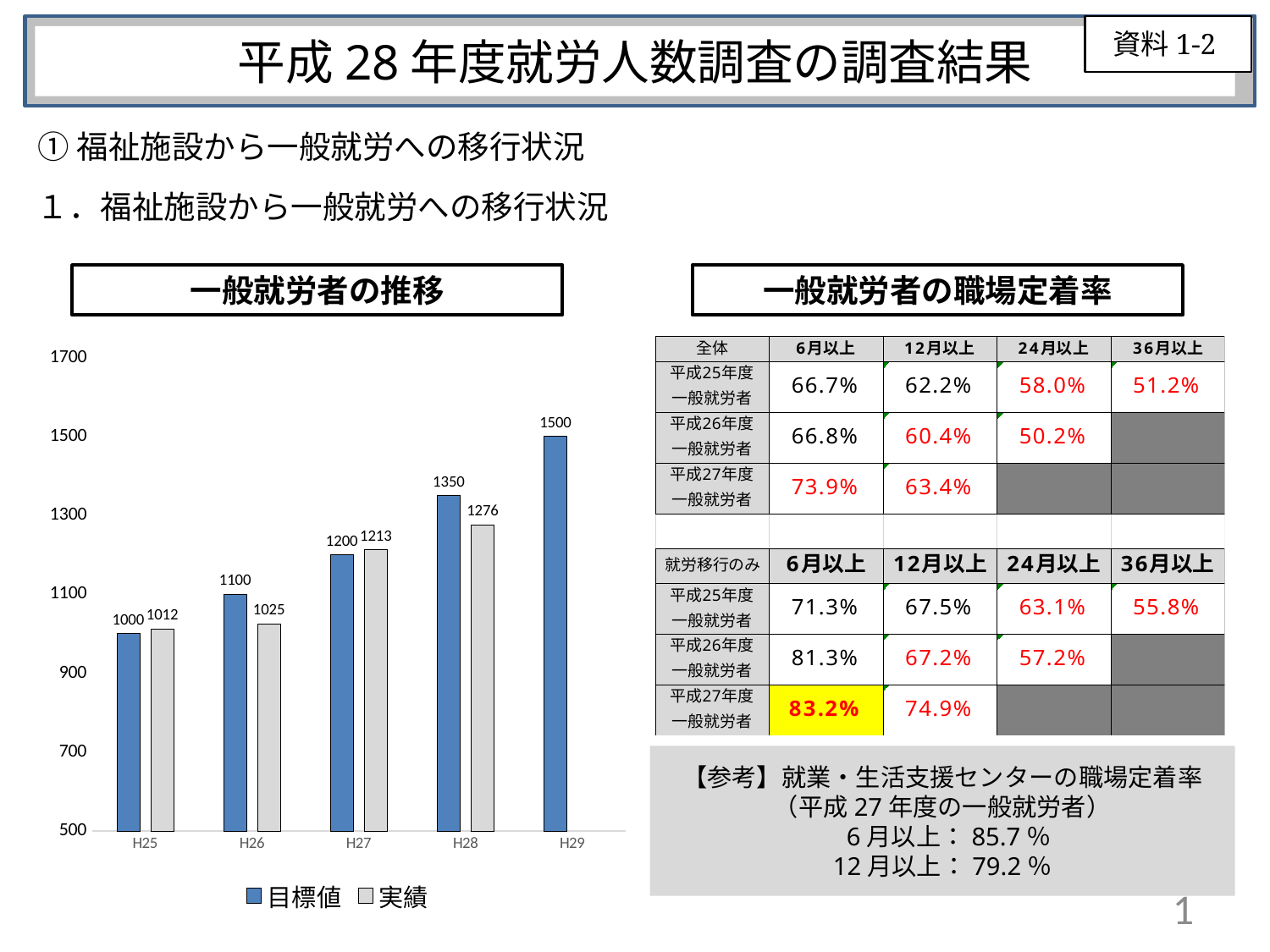
In the chart titled 一般就労者の推移, what is the difference between the 目標値 and 実績 values for H26? 75 In the chart titled 一般就労者の推移, what is the difference between the 目標値 and 実績 values for H28? 74 In the chart titled 一般就労者の推移, how many years are shown on the x axis? 5 In the chart titled 一般就労者の推移, what is the 目標値 value for H28? 1350 In the chart titled 一般就労者の推移, what is the 目標値 value for H29? 1500 In the chart titled 一般就労者の推移, how many series does the legend list? 2 In the chart titled 一般就労者の推移, which is larger for H27, the 目標値 or the 実績? 実績 In the chart titled 一般就労者の推移, what is the 実績 value for H27? 1213 In the chart titled 一般就労者の推移, which year has the highest 目標値? H29 In the chart titled 一般就労者の推移, which year has the lowest 実績 value? H25 In the chart titled 一般就労者の推移, do the 目標値 values rise or fall from H25 to H29? rise In the chart titled 一般就労者の推移, what is the 実績 value for H25? 1012